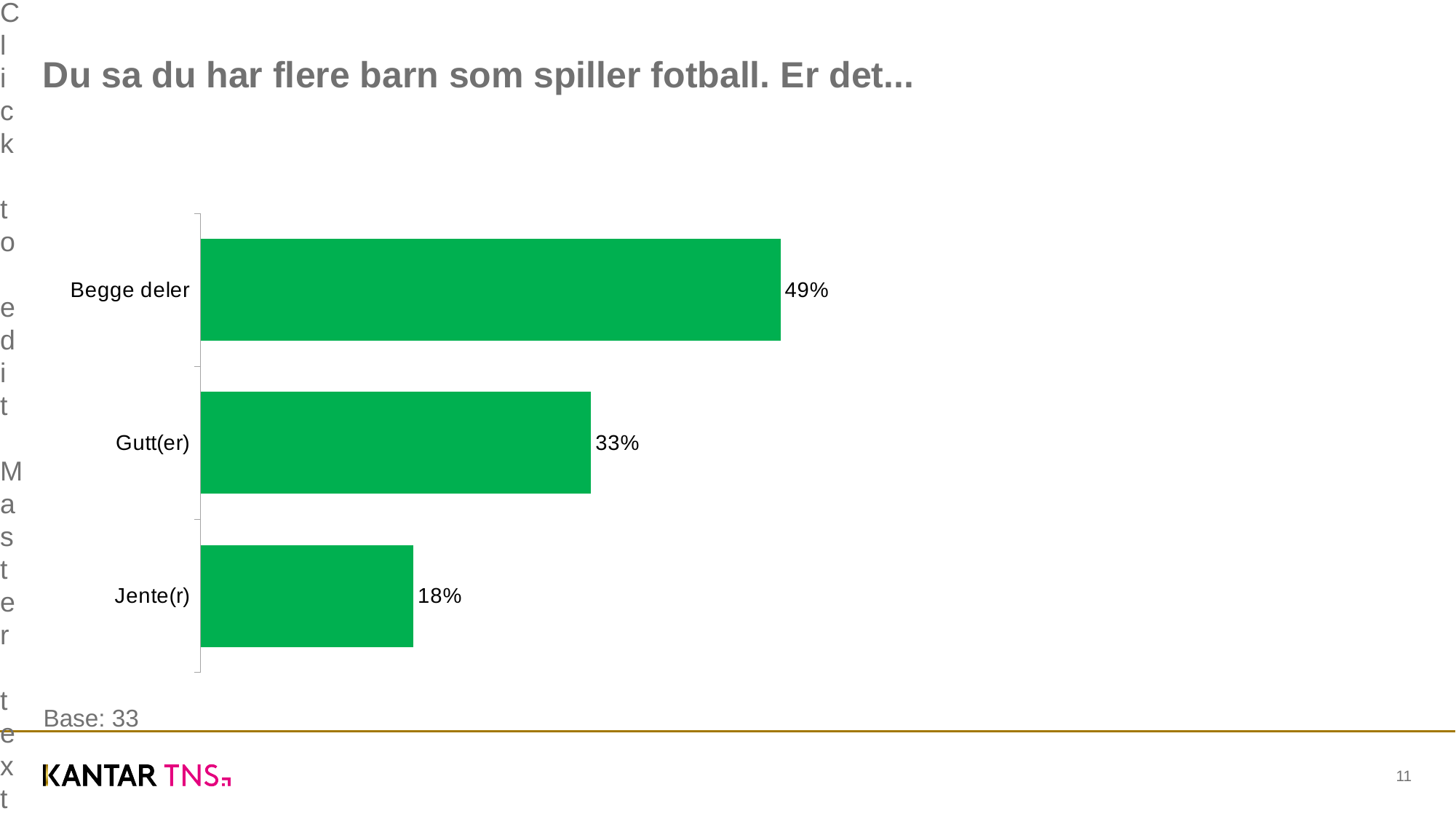
How many categories are shown in the chart? 3 What is the value for Begge deler? 49% What is the difference between the values for Gutt(er) and Jente(r)? 15% What is the difference between the values for Begge deler and Gutt(er)? 16% What is the value for Gutt(er)? 33% What is the base (number of respondents) stated below the chart? 33 Which category has the lowest value? Jente(r) Which is larger, the value for Gutt(er) or the value for Jente(r)? Gutt(er) What kind of chart is shown on the slide? Bar chart What is the value for Jente(r)? 18% Which category has the highest value? Begge deler What colour are the bars in the chart? Green